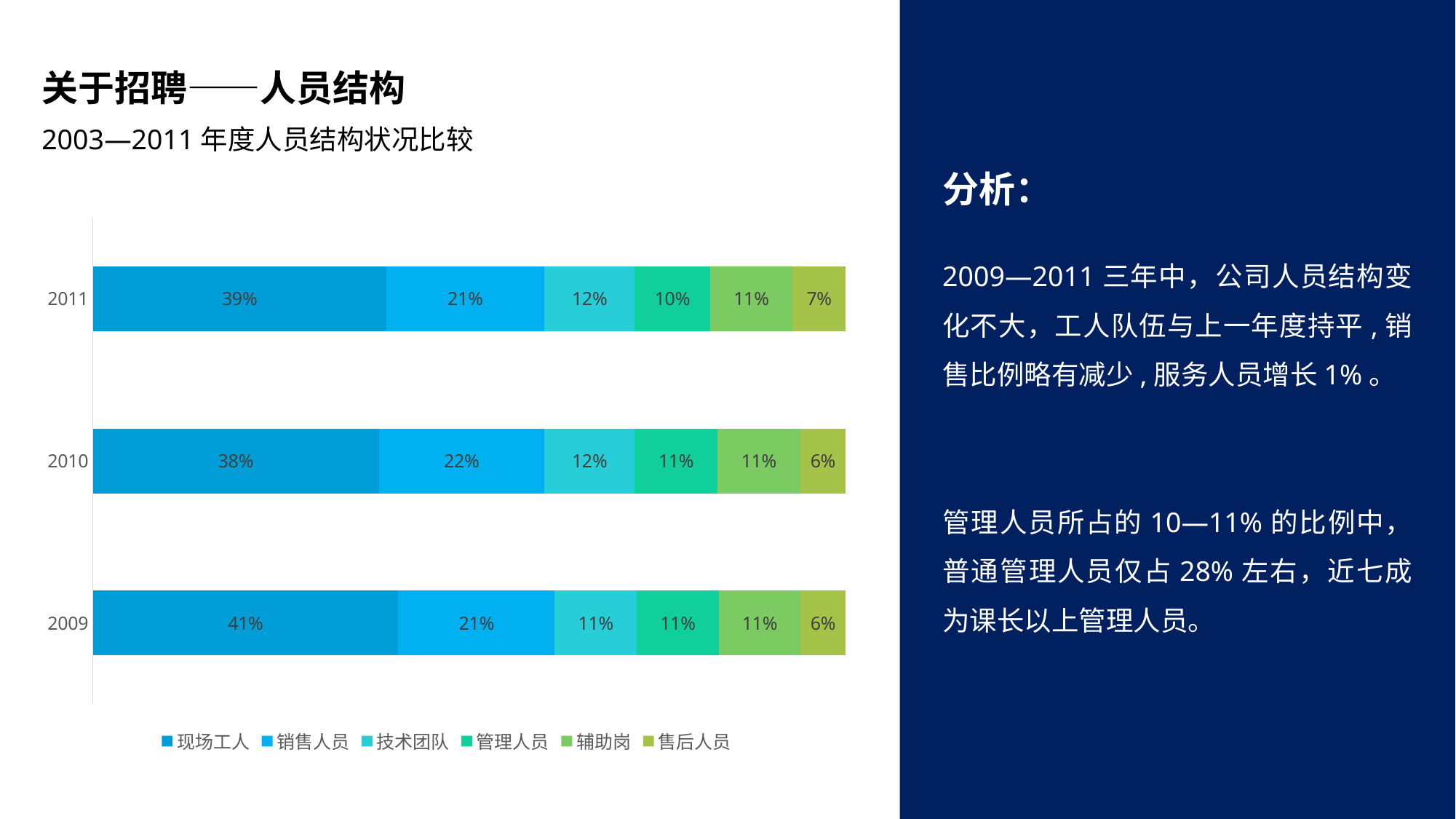
What is the value for 管理人员 in 2011? 10% What is the value for 售后人员 in 2009? 6% What is the value for 现场工人 in 2011? 39% In which year is the 售后人员 share highest? 2011 What is the value for 销售人员 in 2010? 22% What type of chart is shown on the slide? Stacked bar chart What is the total of the stacked bar for 2011? 100% In which year is the 现场工人 share highest? 2009 Which is larger in 2010: the 销售人员 share or the 技术团队 share? 销售人员 What is the difference between the 现场工人 share in 2009 and in 2011? 2% How many series does the legend list? 6 How many years (categories) are plotted on the chart? 3